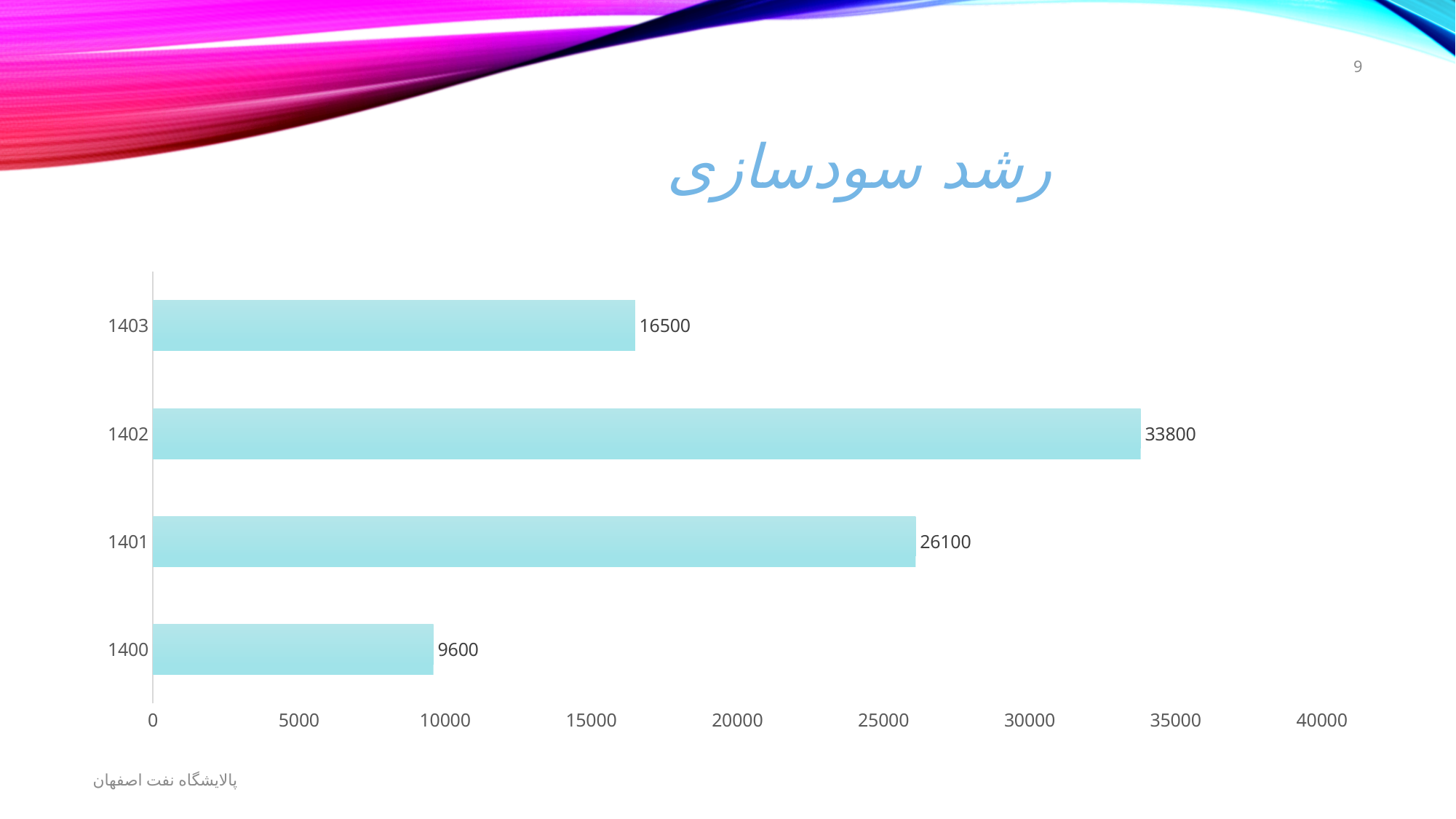
What is the value for 1403? 16500 What is the value for 1402? 33800 What is the difference between the values for 1403 and 1400? 6900 Which category has the lowest value? 1400 What is the value for 1400? 9600 Which is larger, the value for 1401 or the value for 1403? 1401 What is the difference between the values for 1402 and 1401? 7700 How many categories are shown in the chart? 4 What is the value for 1401? 26100 Is the value for 1402 greater or less than 30000? greater Which category has the highest value? 1402 What kind of chart is shown on the slide? bar chart